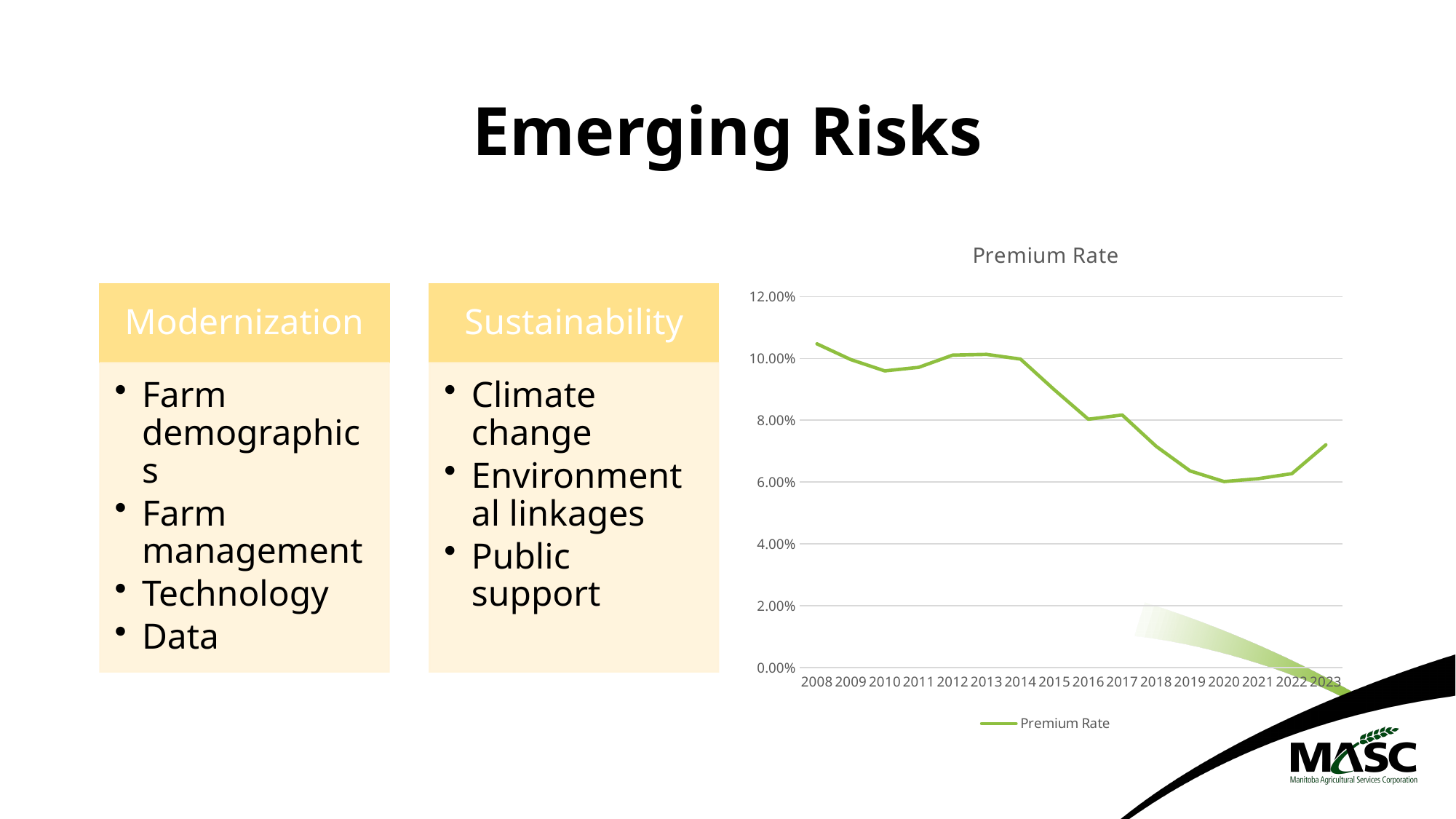
Is the premium rate for 2010 greater or less than 10.00%? less How many years are plotted on the x axis of the Premium Rate chart? 16 What kind of chart is the Premium Rate chart? line chart Is the premium rate for 2008 greater or less than 10.00%? greater Which year has the highest premium rate in the chart? 2008 Which year has the larger premium rate, 2008 or 2023? 2008 Is the premium rate for 2020 greater or less than 8.00%? less What is the title of the chart on the slide? Premium Rate Does the premium rate generally rise or fall from 2008 to 2020? fall How many series does the legend of the Premium Rate chart list? 1